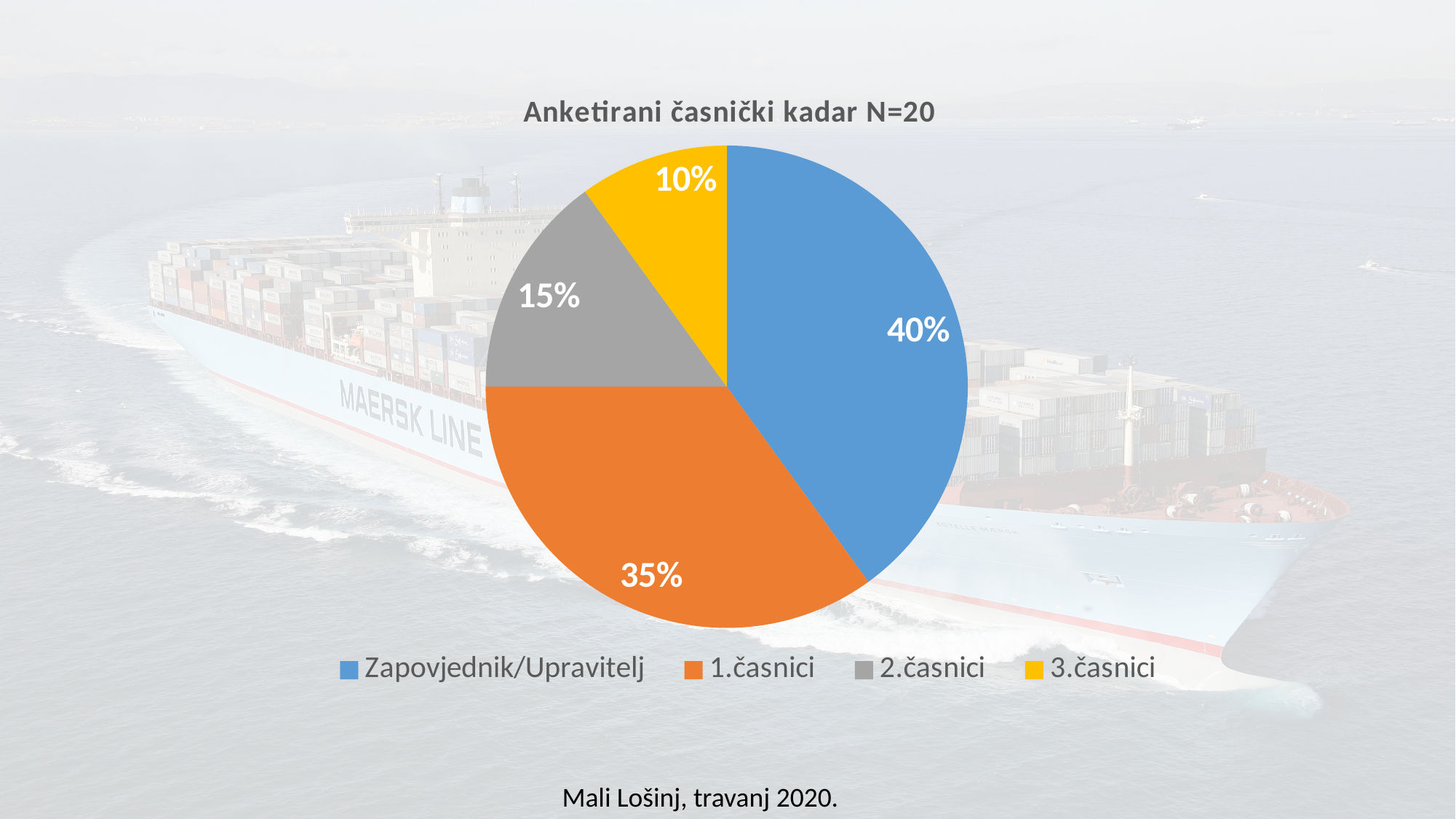
How many categories does the pie chart show? 4 What type of chart is shown on the slide? pie chart What colour is the slice for 1.časnici? orange What is the difference in percentage points between Zapovjednik/Upravitelj and 1.časnici? 5% Which category has the smallest slice of the pie? 3.časnici What share of the pie does 2.časnici have? 15% What is the title of the chart? Anketirani časnički kadar N=20 Which category has the largest slice of the pie? Zapovjednik/Upravitelj What share of the pie does 3.časnici have? 10% Which is larger, the share for 2.časnici or the share for 3.časnici? 2.časnici What share of the pie does 1.časnici have? 35%